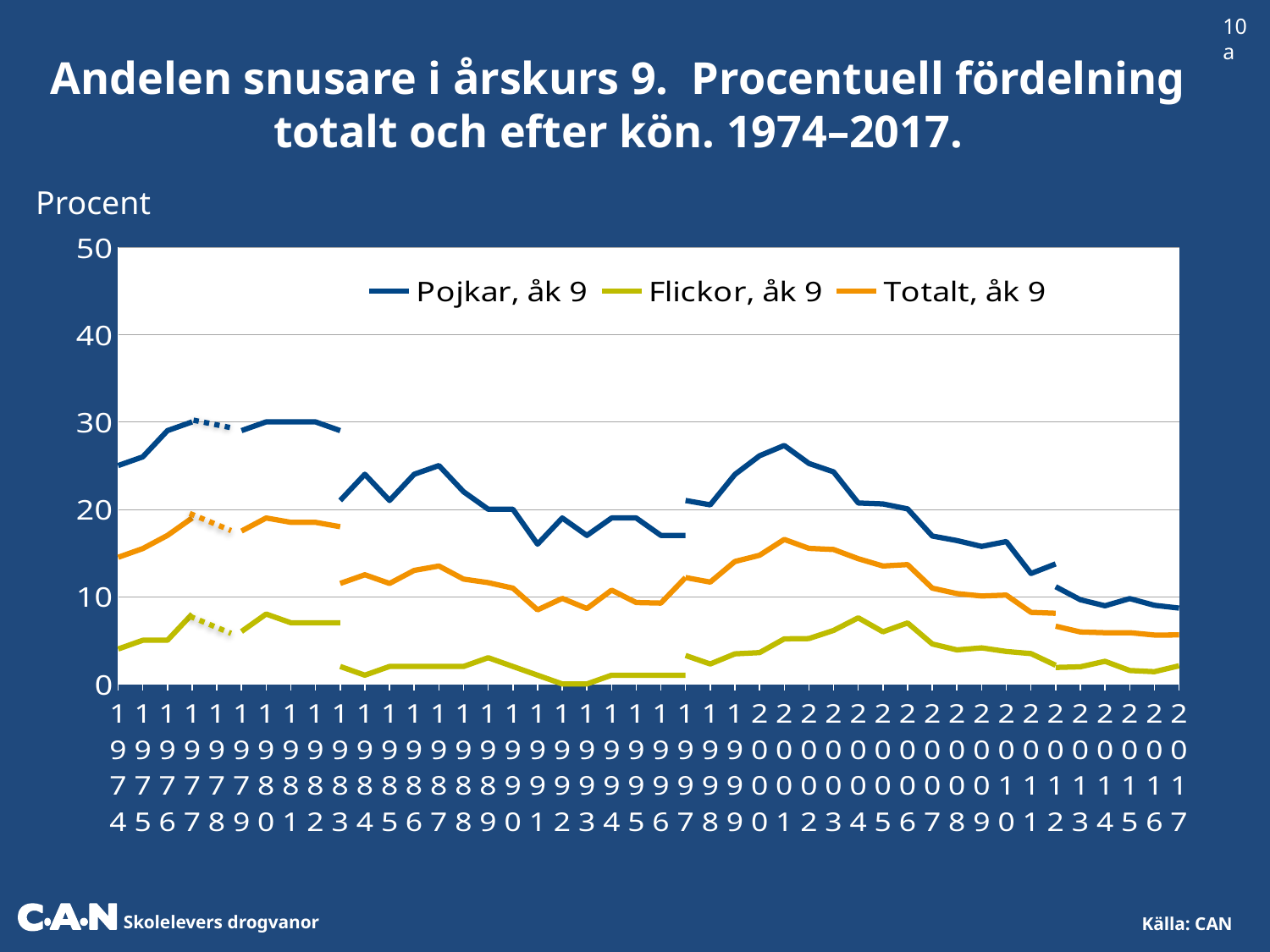
Is the value for Totalt, åk 9 in 2001 greater or less than 10? greater Is the value for Pojkar, åk 9 in 1974 greater or less than 20? greater How many series does the legend list? 3 Which series has the higher value in 2001, Pojkar, åk 9 or Flickor, åk 9? Pojkar, åk 9 What are the three series named in the legend? Pojkar, åk 9; Flickor, åk 9; Totalt, åk 9 Is the value for Pojkar, åk 9 in 2001 greater or less than 20? greater What label is shown above the vertical axis? Procent What kind of chart is shown on the slide? line chart Which series has the lowest values across the whole period? Flickor, åk 9 Does the value for Pojkar, åk 9 rise or fall from 2001 to 2017? fall